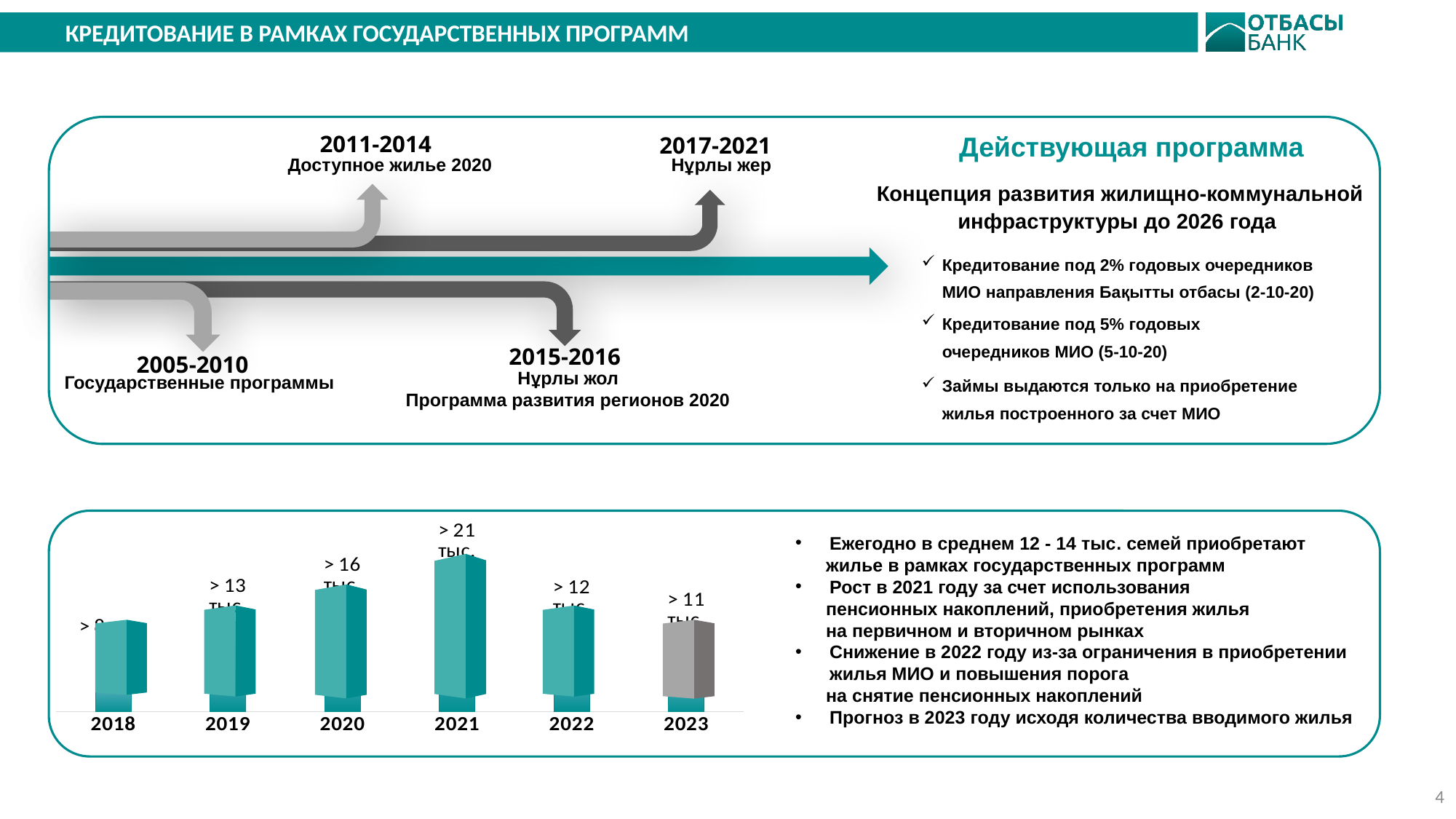
What is the data label shown for 2023 in the bar chart? > 11 тыс. Which year's bar is coloured grey instead of teal in the chart? 2023 What is the data label shown for 2022 in the bar chart? > 12 тыс. Do the bars rise or fall from 2018 to 2021? rise What is the data label shown for 2019 in the bar chart? > 13 тыс. What is the data label shown for 2020 in the bar chart? > 16 тыс. Which bar is taller in the chart, 2020 or 2022? 2020 Which year has the highest bar in the chart? 2021 What kind of chart is shown at the bottom of the slide? bar chart Which year has the lowest bar in the chart? 2018 What is the data label shown for 2021 in the bar chart? > 21 тыс. How many years (bars) are shown in the bar chart? 6